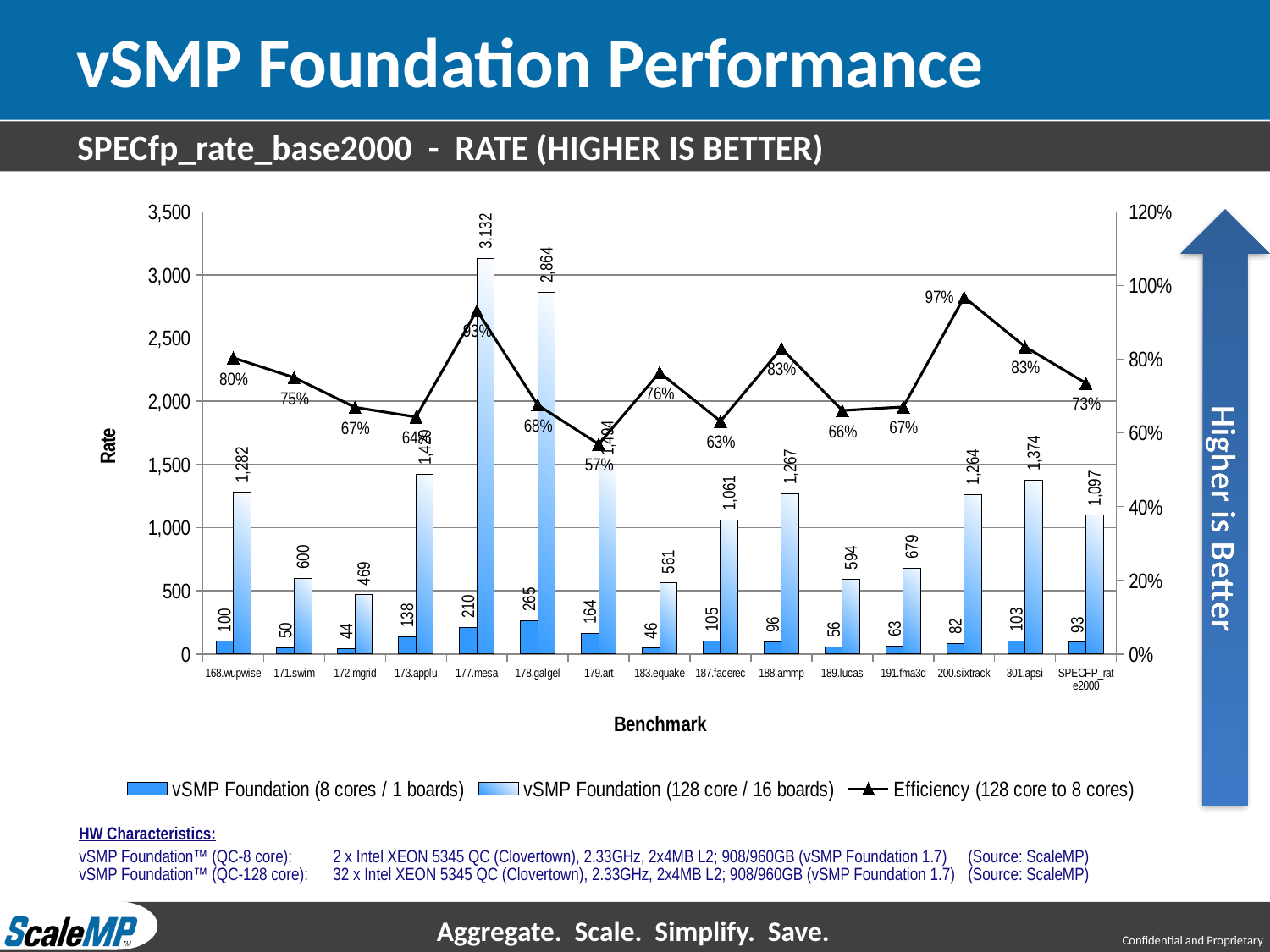
How many benchmarks are shown on the x axis? 15 What is the value of vSMP Foundation (128 core / 16 boards) for 177.mesa? 3,132 Which has the larger vSMP Foundation (128 core / 16 boards) value, 188.ammp or 187.facerec? 188.ammp Which benchmark has the highest vSMP Foundation (128 core / 16 boards) rate? 177.mesa What is the Efficiency (128 core to 8 cores) value for 168.wupwise? 80% How many series does the legend list? 3 What is the difference between the vSMP Foundation (128 core / 16 boards) values for 177.mesa and 178.galgel? 268 What is the value of vSMP Foundation (8 cores / 1 boards) for 178.galgel? 265 Which benchmark has the highest Efficiency (128 core to 8 cores)? 200.sixtrack Which benchmark has the lowest vSMP Foundation (8 cores / 1 boards) rate? 172.mgrid What kind of chart is shown on the slide? Bar and line chart Which benchmark has the lowest Efficiency (128 core to 8 cores)? 179.art